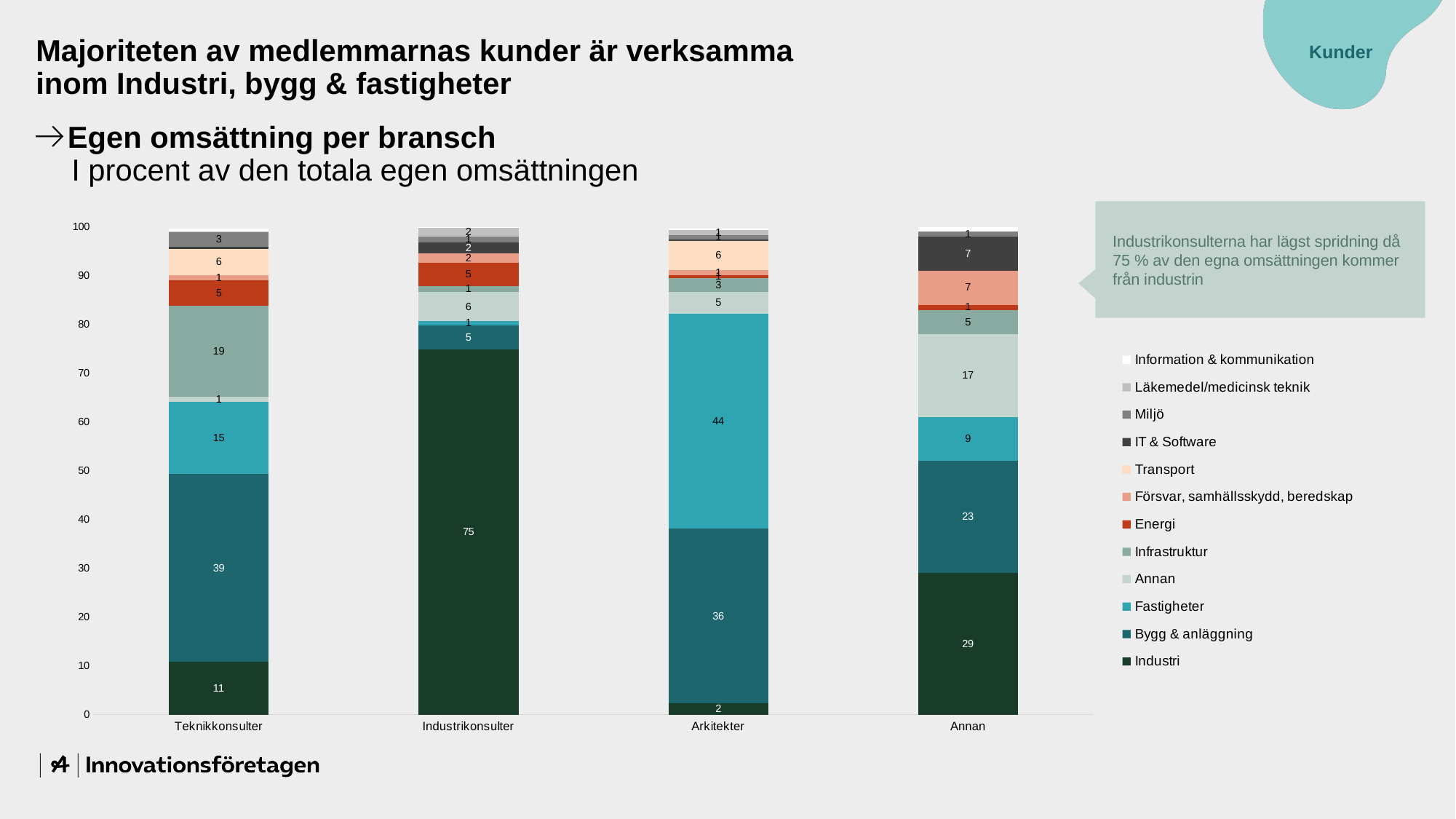
How many series does the legend list? 12 How many categories are shown on the x axis? 4 What is the difference between the Bygg & anläggning values for Teknikkonsulter and Arkitekter? 3 What is the value of Industri for Annan? 29 Which has the larger Fastigheter value, Arkitekter or Annan? Arkitekter What is the value of Infrastruktur for Teknikkonsulter? 19 What is the value of Bygg & anläggning for Teknikkonsulter? 39 What is the value of Fastigheter for Arkitekter? 44 Which category has the lowest value for Industri? Arkitekter What is the value of Industri for Industrikonsulter? 75 What kind of chart is shown on the slide? Stacked bar chart Which category has the highest value for Industri? Industrikonsulter